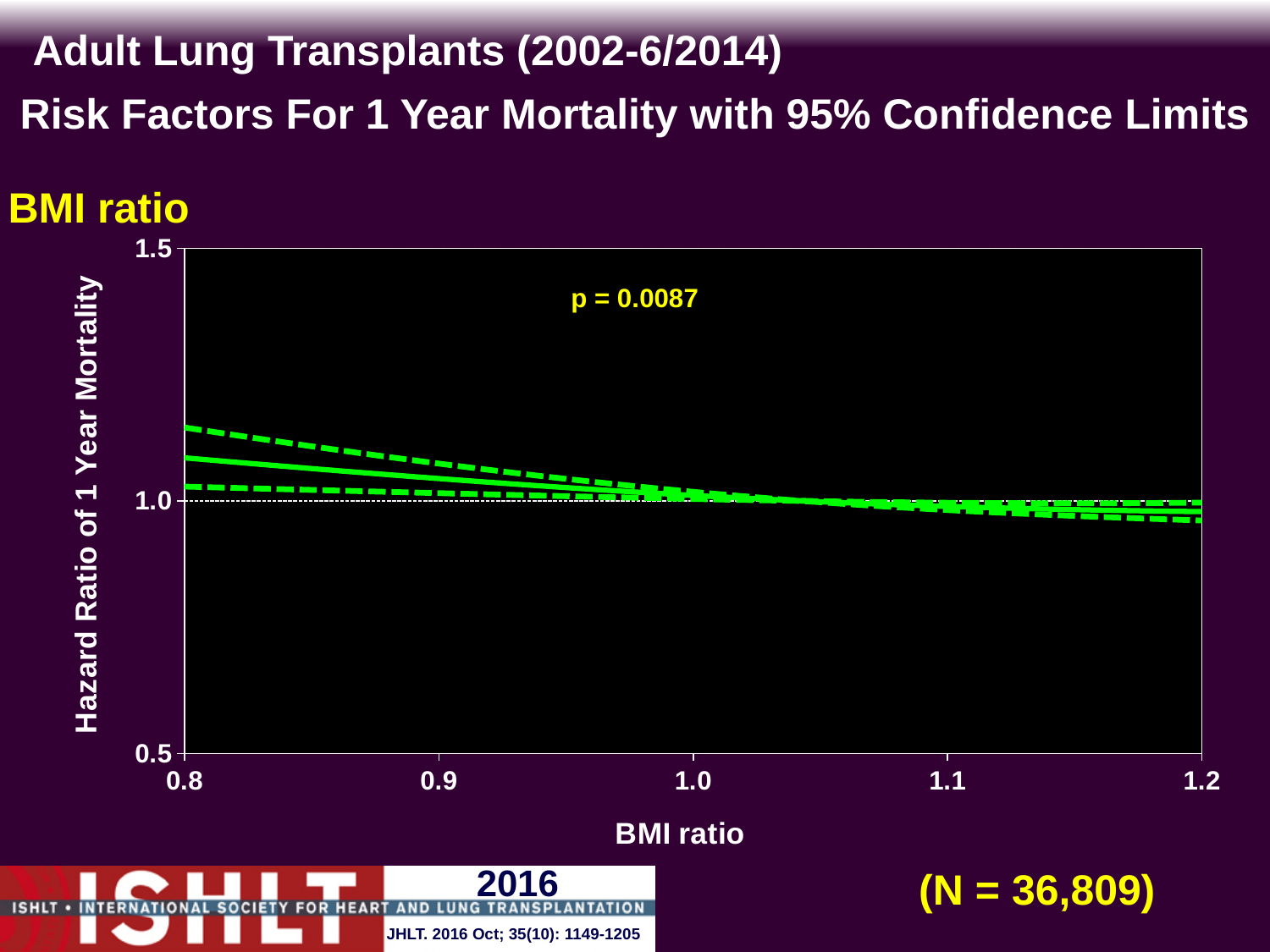
Is the upper 95% confidence limit at a BMI ratio of 0.8 greater or less than 1.0? greater Is the lower 95% confidence limit at a BMI ratio of 1.2 greater or less than 0.5? greater What p-value is printed on the chart? p = 0.0087 Does the hazard ratio rise or fall as the BMI ratio increases from 0.8 to 1.2? fall What sample size (N) is shown on the slide? N = 36,809 Is the hazard ratio at a BMI ratio of 0.8 greater or less than 1.5? less Is the hazard ratio at a BMI ratio of 0.8 larger or smaller than the hazard ratio at a BMI ratio of 1.2? larger What kind of chart is shown on the slide? line chart